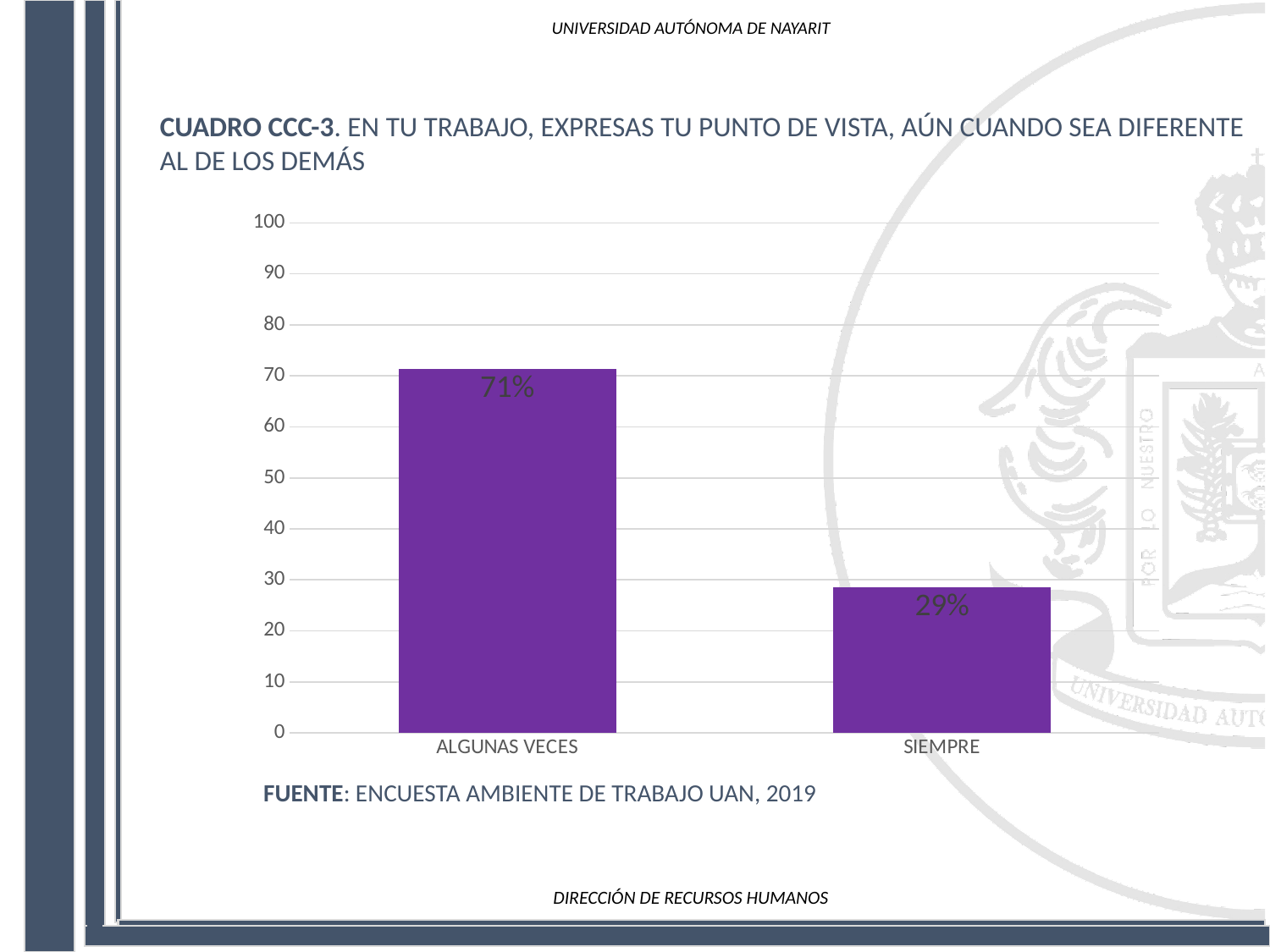
Is the value for ALGUNAS VECES greater or less than 60? greater What is the maximum value shown on the y axis? 100 How many categories are shown on the x axis? 2 Which category has the lowest value? SIEMPRE What is the value for SIEMPRE? 29% Which is larger, the value for ALGUNAS VECES or the value for SIEMPRE? ALGUNAS VECES Is the value for SIEMPRE greater or less than 40? less What is the value for ALGUNAS VECES? 71% What is the source cited below the chart? ENCUESTA AMBIENTE DE TRABAJO UAN, 2019 What is the difference between the values for ALGUNAS VECES and SIEMPRE? 42% Which category has the highest value? ALGUNAS VECES What kind of chart is shown on the slide? bar chart